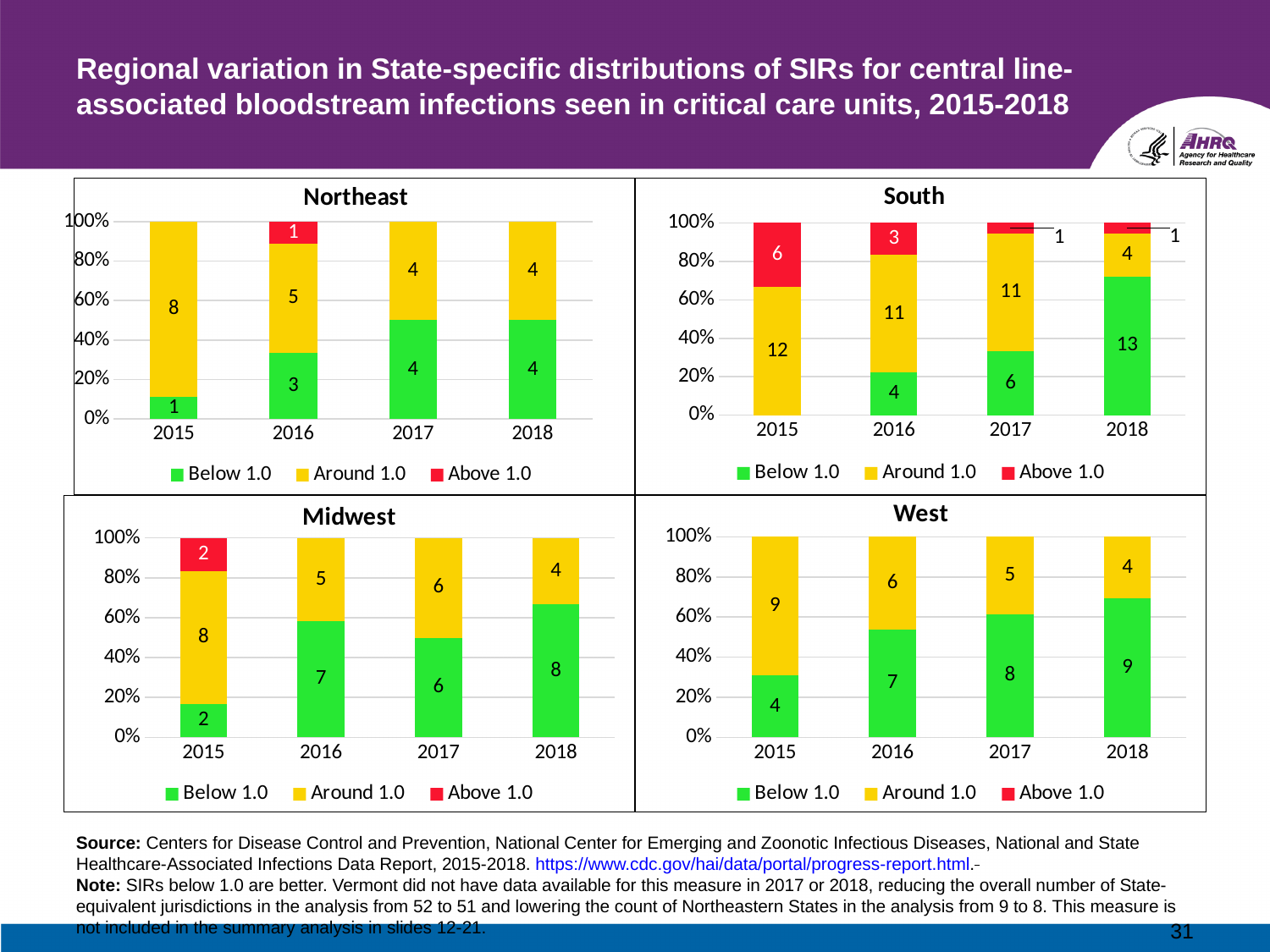
How many series does the legend of the Midwest chart list? 3 In the South chart, what is the total number of States represented in the 2018 bar? 18 In the West chart, does the number of States in the Below 1.0 category rise or fall from 2015 to 2018? rise In the West chart, which year has the highest number of States in the Below 1.0 category? 2018 What kind of chart is the South chart? stacked bar chart In the South chart, how many States were in the Above 1.0 category in 2015? 6 In the South chart, which year has the lowest number of States in the Around 1.0 category? 2018 In the Northeast chart, what is the difference between the Around 1.0 count in 2015 and the Around 1.0 count in 2016? 3 In the Midwest chart, how many States were in the Below 1.0 category in 2018? 8 In the Midwest chart, what is the total number of States represented in the 2015 bar? 12 In the West chart, how many States were in the Around 1.0 category in 2016? 6 In the Northeast chart, how many States were in the Around 1.0 category in 2015? 8